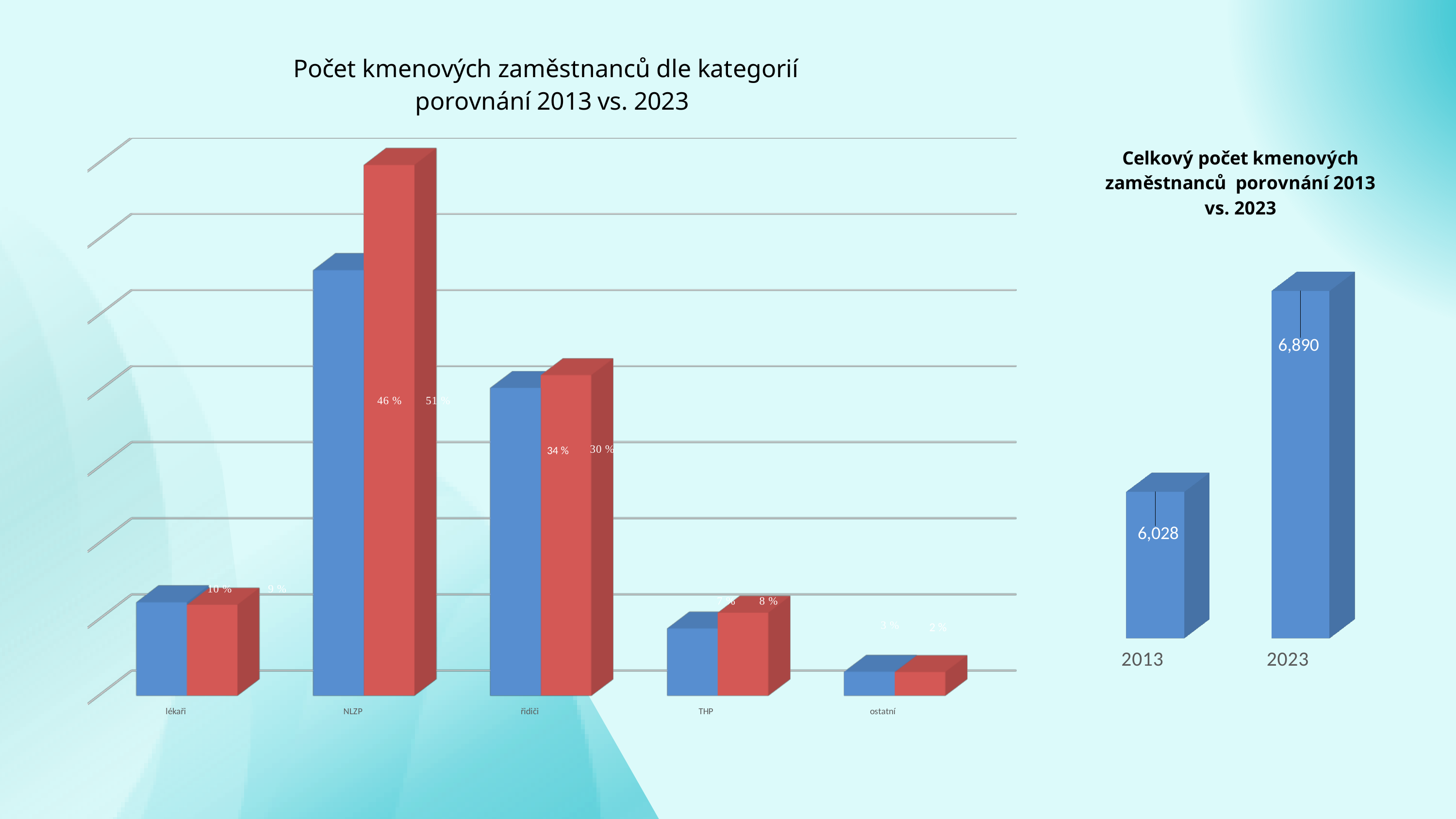
In the chart 'Celkový počet kmenových zaměstnanců porovnání 2013 vs. 2023', what is the value for 2023? 6,890 In the chart 'Počet kmenových zaměstnanců dle kategorií porovnání 2013 vs. 2023', what is the difference between the blue and red bars for řidiči? 4 % In the chart 'Počet kmenových zaměstnanců dle kategorií porovnání 2013 vs. 2023', which category has the lowest red bar? ostatní What kind of chart is the one on the left of the slide? Bar chart In the chart 'Počet kmenových zaměstnanců dle kategorií porovnání 2013 vs. 2023', how many categories are shown on the x axis? 5 In the chart 'Celkový počet kmenových zaměstnanců porovnání 2013 vs. 2023', what is the difference between the 2023 and 2013 values? 862 In the chart 'Počet kmenových zaměstnanců dle kategorií porovnání 2013 vs. 2023', what is the value of the blue bar for lékaři? 10 % In the chart 'Celkový počet kmenových zaměstnanců porovnání 2013 vs. 2023', which year has the higher value? 2023 In the chart 'Počet kmenových zaměstnanců dle kategorií porovnání 2013 vs. 2023', which category has the highest blue bar? NLZP In the chart 'Počet kmenových zaměstnanců dle kategorií porovnání 2013 vs. 2023', what is the value of the blue bar for řidiči? 34 % In the chart 'Celkový počet kmenových zaměstnanců porovnání 2013 vs. 2023', what is the value for 2013? 6,028 In the chart 'Počet kmenových zaměstnanců dle kategorií porovnání 2013 vs. 2023', what is the value of the red bar for NLZP? 51 %